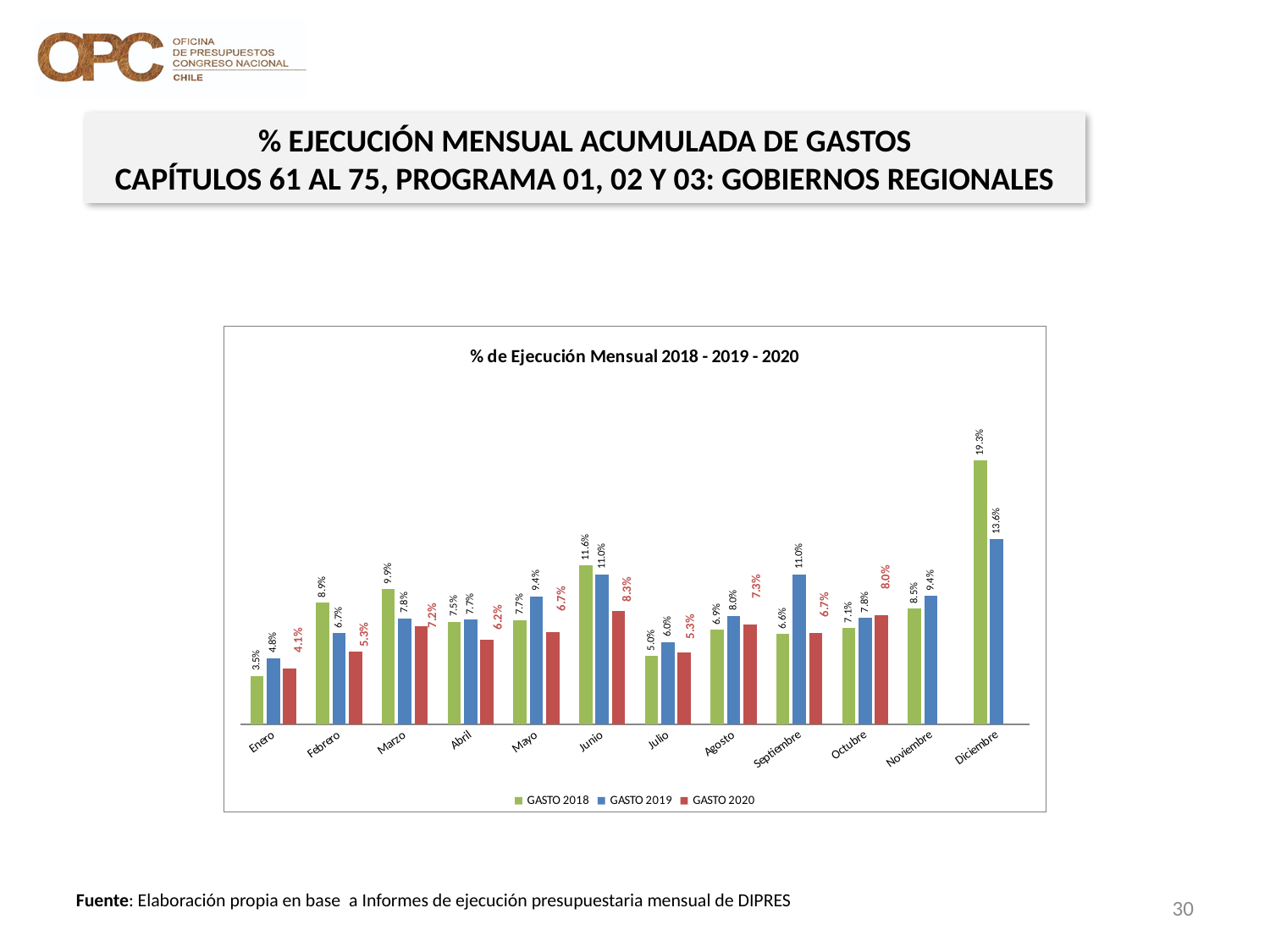
What is the value for GASTO 2018 in Diciembre? 19.3% What kind of chart is shown on the slide? Bar chart In Septiembre, which is larger: GASTO 2018 or GASTO 2019? GASTO 2019 Which month has the lowest value for GASTO 2018? Enero Which month has the highest value for GASTO 2020? Junio What is the difference between GASTO 2018 and GASTO 2020 in Junio? 3.3 percentage points What is the value for GASTO 2019 in Mayo? 9.4% Which month has the highest value for GASTO 2019? Diciembre What is the value for GASTO 2020 in Octubre? 8.0% How many series does the chart legend list? 3 What is the difference between GASTO 2018 and GASTO 2019 in Diciembre? 5.7 percentage points How many months are shown on the x axis of the chart? 12